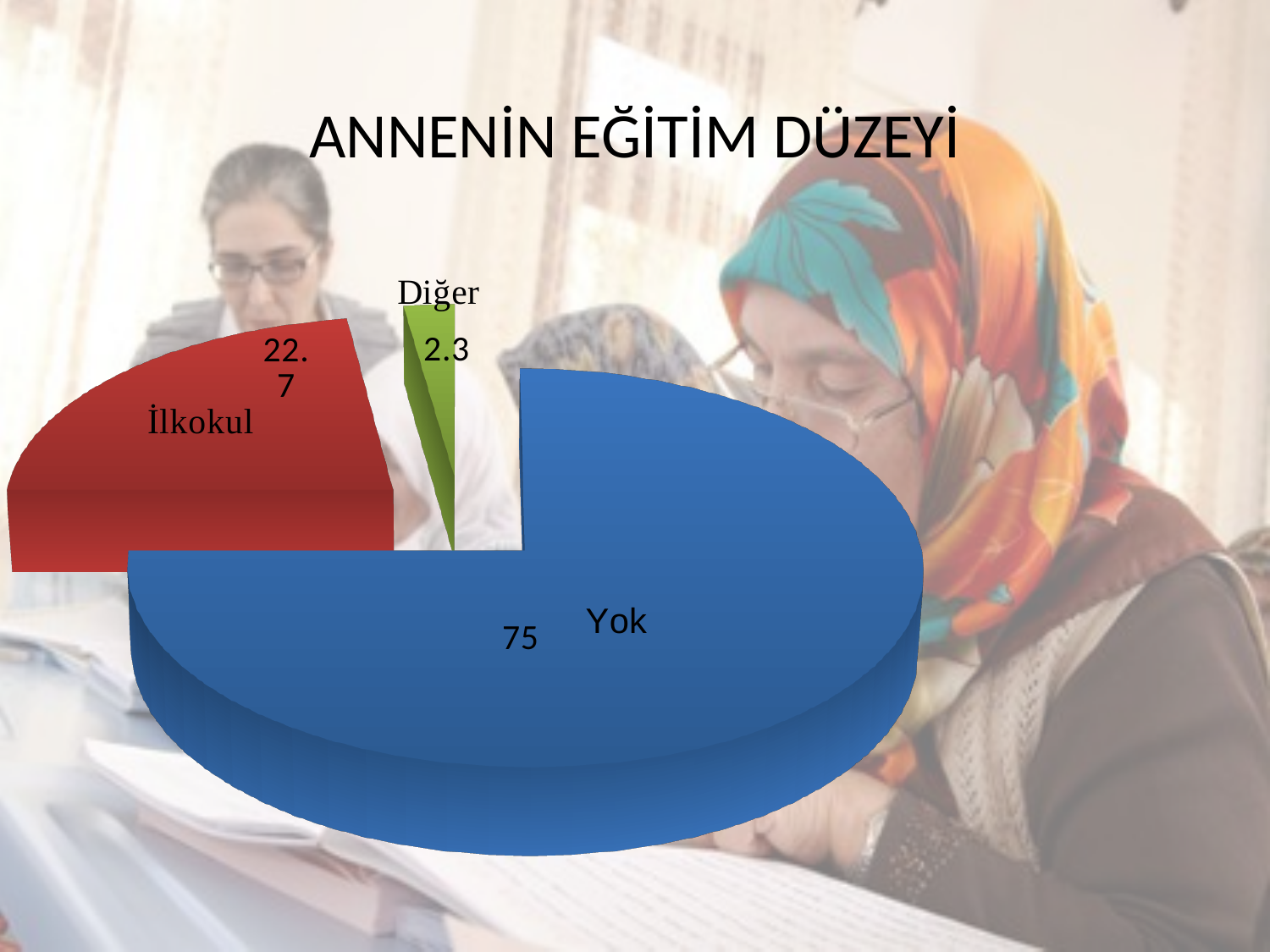
Which is larger, the value for İlkokul or the value for Diğer? İlkokul Which slice of the pie is the largest? Yok What is the value shown for the Yok slice? 75 What is the difference between the values for İlkokul and Diğer? 20.4 What is the title of the chart? ANNENİN EĞİTİM DÜZEYİ What is the difference between the values for Yok and İlkokul? 52.3 What colour is the Yok slice? blue Which slice of the pie is the smallest? Diğer How many slices does the pie chart have? 3 What is the value shown for the İlkokul slice? 22.7 What is the value shown for the Diğer slice? 2.3 What kind of chart is shown on the slide? pie chart